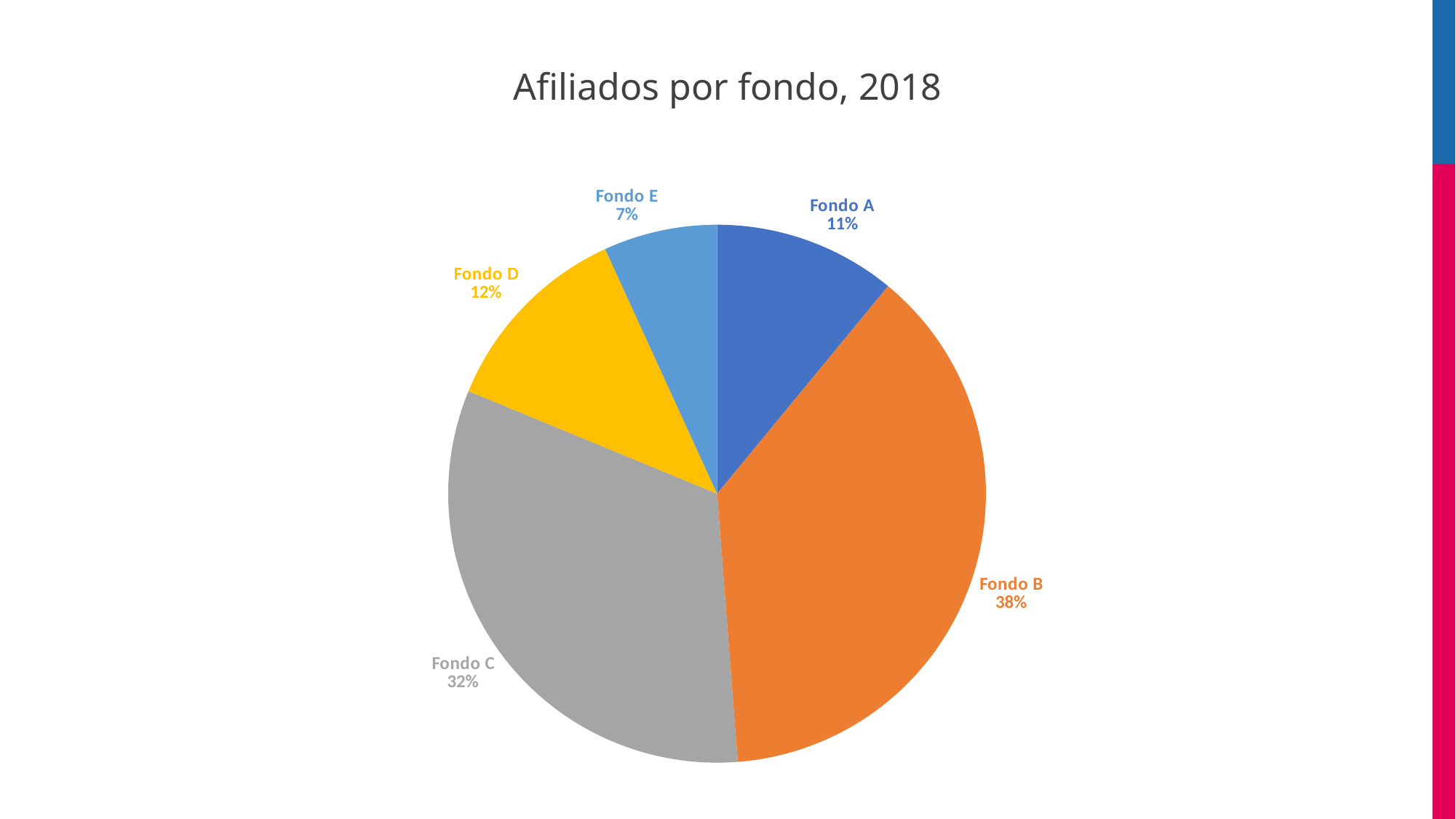
Which is larger, the share for Fondo A or the share for Fondo D? Fondo D What percentage is shown for Fondo E? 7% Which fondo has the largest share of the pie? Fondo B What kind of chart is shown on the slide? Pie chart How many slices does the pie chart have? 5 Which fondo has the smallest share of the pie? Fondo E What is the value shown for Fondo D? 12% What is the value shown for Fondo C? 32% What colour is the slice for Fondo C? Grey What share of the pie does Fondo B represent? 38% What is the title of the chart? Afiliados por fondo, 2018 What is the difference in percentage points between Fondo B and Fondo C? 6